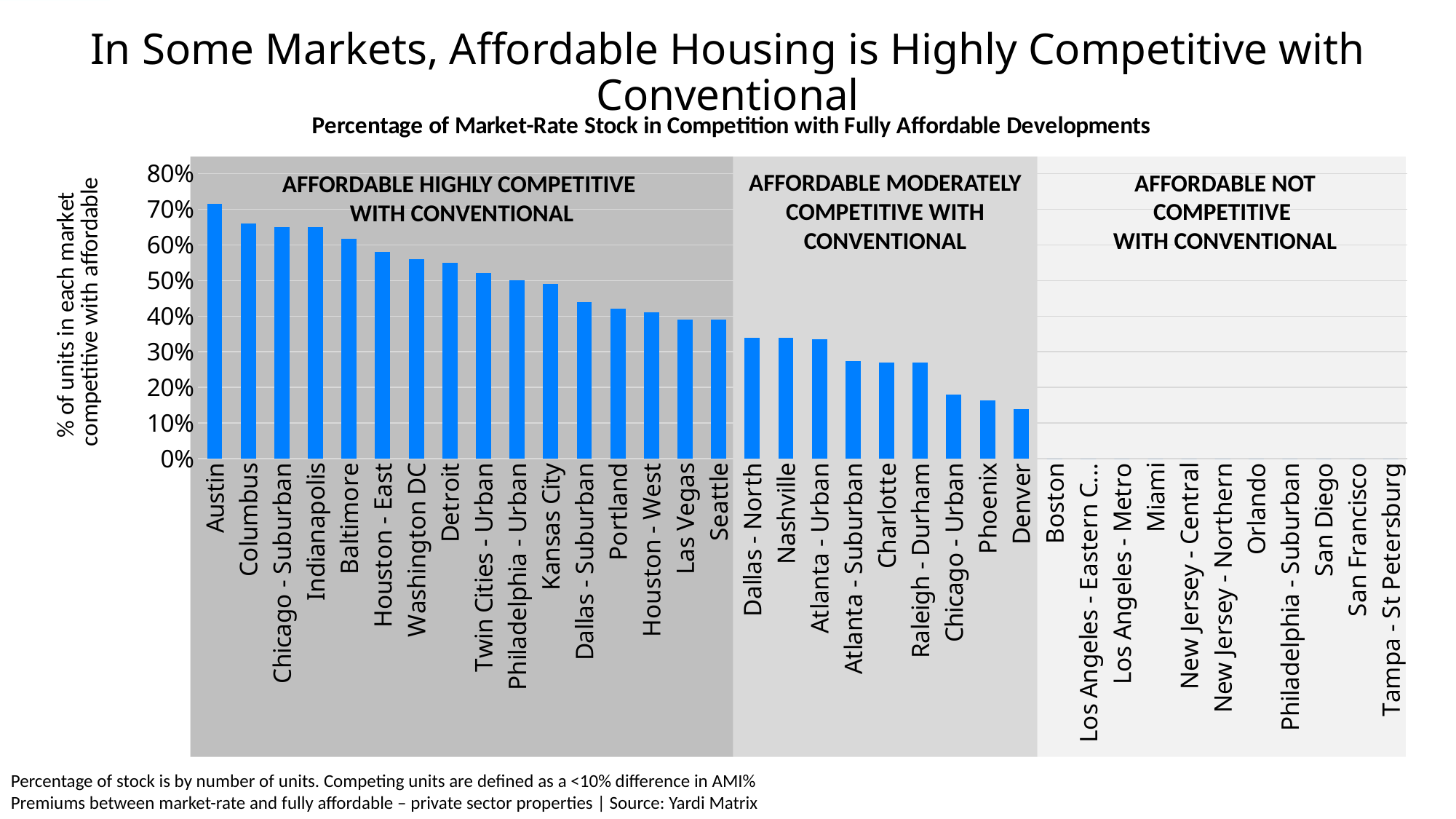
Is the value for Denver greater or less than 20%? less What is the chart's subtitle describing the measure plotted? Percentage of Market-Rate Stock in Competition with Fully Affordable Developments Is the value for Charlotte greater or less than 30%? less How many cities are listed in the 'Affordable Moderately Competitive with Conventional' group? 9 Is the value for Detroit greater or less than 50%? greater Which city has the highest percentage of market-rate stock in competition with fully affordable developments? Austin Which has a higher value, Baltimore or Detroit? Baltimore Do the bar values rise or fall moving from left to right along the x axis? fall Which has a higher value, Nashville or Denver? Nashville What kind of chart is shown on the slide? bar chart